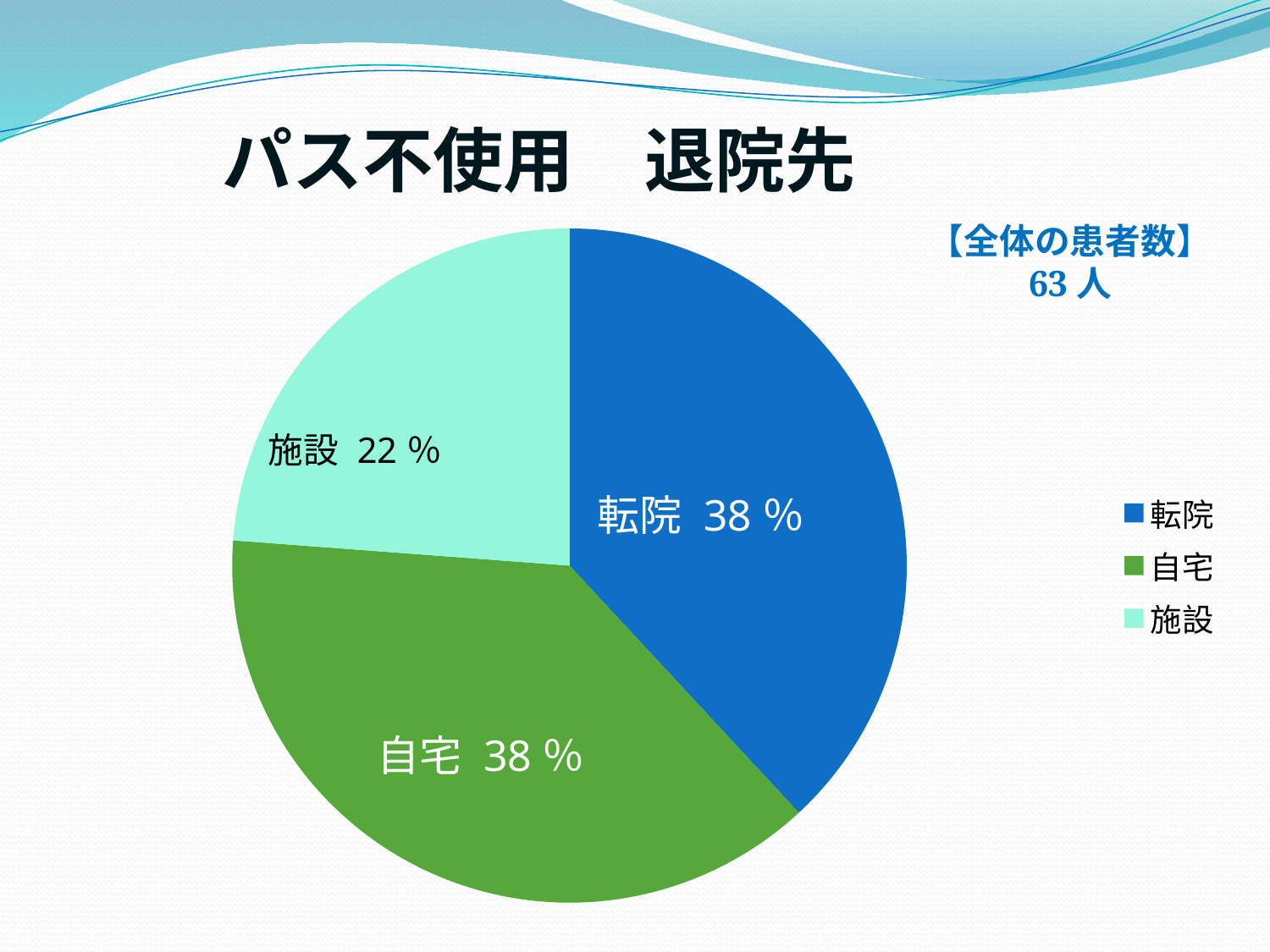
What is the total number of patients stated on the slide? 63 人 How many slices does the pie chart have? 3 What share of the pie does 転院 account for? 38 % Which category has the smallest slice of the pie? 施設 How many entries does the legend list? 3 Is the share for 施設 greater or less than 25%? less Which is larger, the slice for 転院 or the slice for 施設? 転院 What is the title of the chart on the slide? パス不使用 退院先 By how many percentage points does 自宅 exceed 施設? 16 What percentage is shown for 自宅? 38 % What percentage is shown for 施設? 22 % What kind of chart is shown on the slide? Pie chart